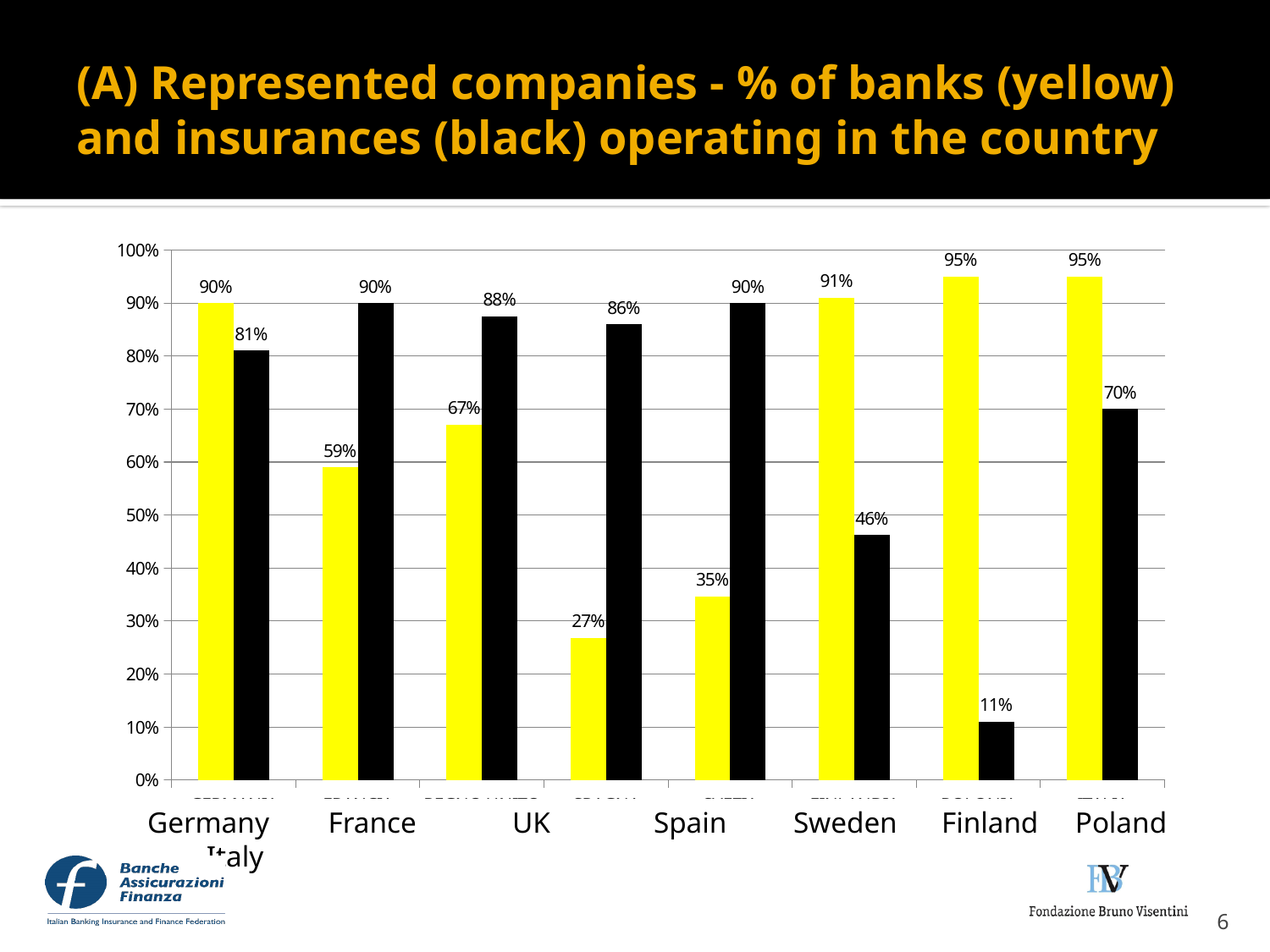
What kind of chart is shown on the slide? bar chart Which country has the lowest percentage of represented insurances? Poland What is the difference between the banks and insurances percentages for Germany? 9 percentage points What is the value for insurances in Poland? 11% Which country has the lowest percentage of represented banks? Spain In France, which is larger: the percentage of represented banks or of represented insurances? insurances What percentage of banks operating in Germany are represented? 90% What percentage of insurances operating in Spain are represented? 86% What is the difference between the banks and insurances percentages for Finland? 45 percentage points What percentage of banks operating in Spain are represented? 27% How many countries are shown on the chart? 8 Which colour represents banks in the chart? yellow